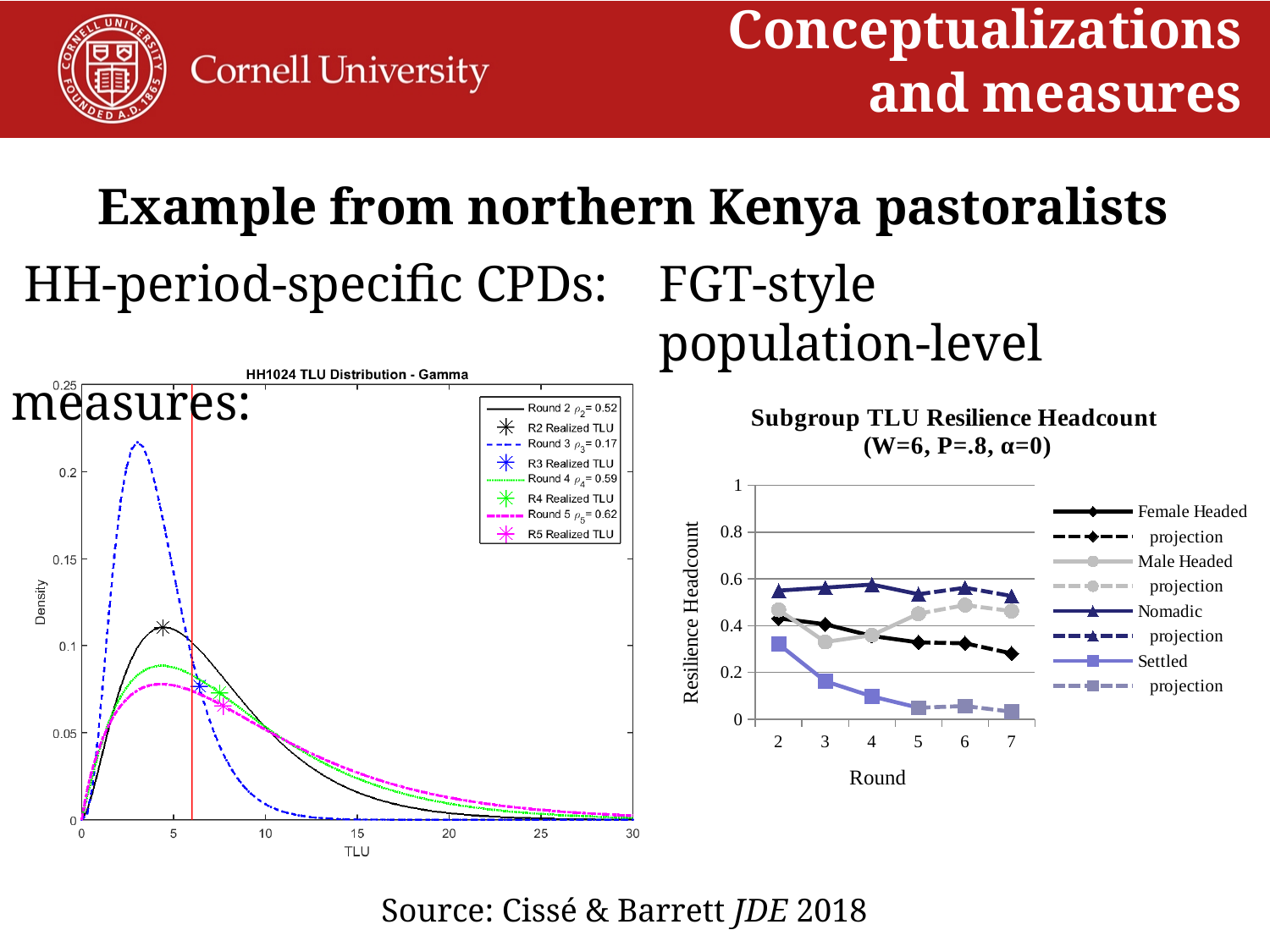
In the 'Subgroup TLU Resilience Headcount' chart, which subgroup has the highest resilience headcount at round 2? Nomadic In the 'Subgroup TLU Resilience Headcount' chart, does the Settled series rise or fall from round 2 to round 7? fall In the 'HH1024 TLU Distribution - Gamma' chart on the left, which round's curve has the highest peak density? Round 3 In the 'Subgroup TLU Resilience Headcount' chart, is the value for Female Headed at round 7 greater or less than 0.4? less In the 'Subgroup TLU Resilience Headcount' chart, is the value for Nomadic at round 4 greater or less than 0.4? greater What kind of chart is the 'Subgroup TLU Resilience Headcount' chart on the right? line chart In the 'Subgroup TLU Resilience Headcount' chart, is the value for Settled at round 7 greater or less than 0.2? less In the 'Subgroup TLU Resilience Headcount' chart, how many entries does the legend list? 8 In the 'Subgroup TLU Resilience Headcount' chart, which subgroup has the lowest resilience headcount at round 7? Settled In the 'Subgroup TLU Resilience Headcount' chart, how many rounds are shown on the x axis? 6 What is the label on the x axis of the 'HH1024 TLU Distribution - Gamma' chart on the left? TLU In the 'Subgroup TLU Resilience Headcount' chart, which is larger at round 3: Nomadic or Settled? Nomadic